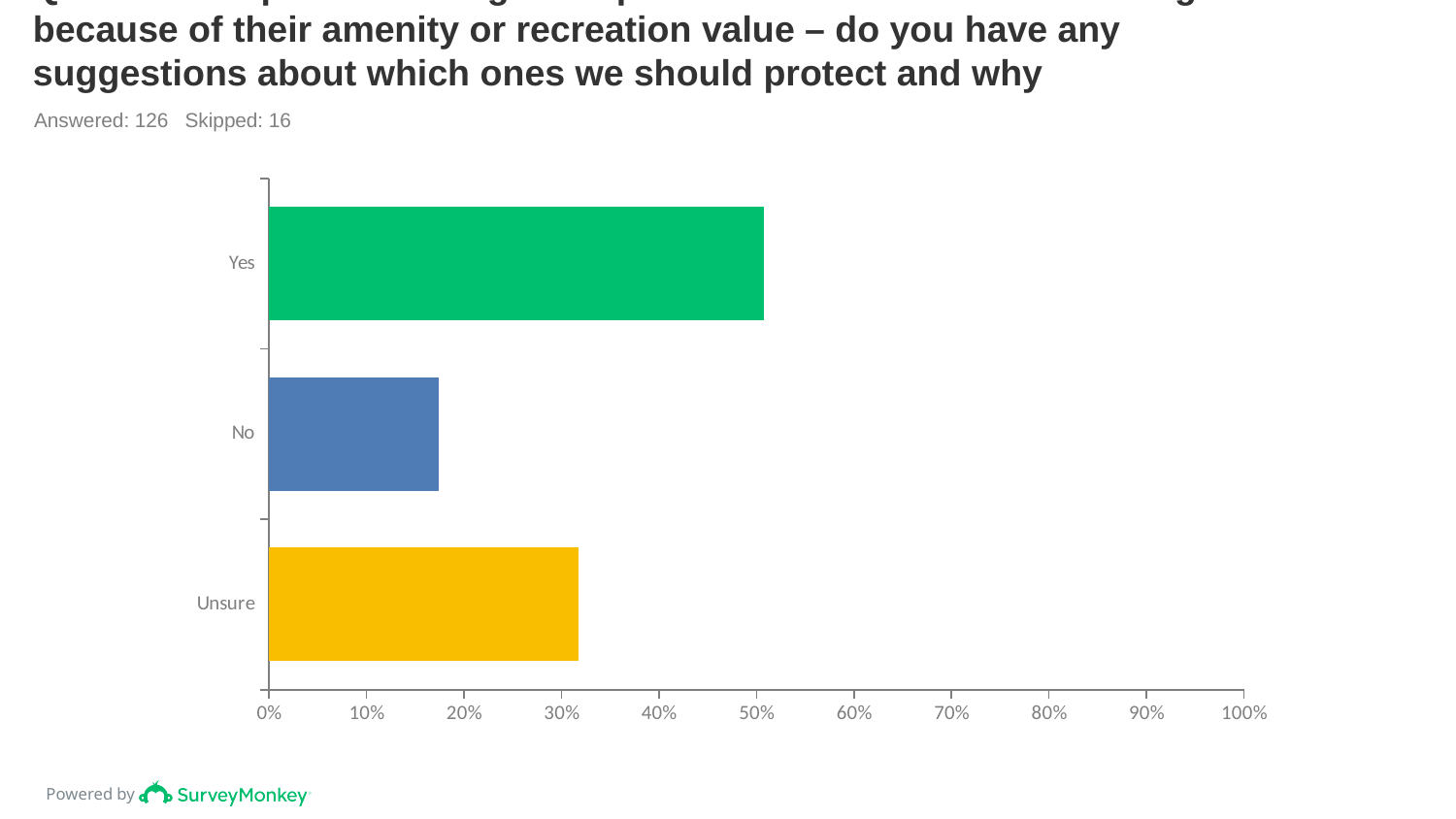
Which response category has the lowest value? No How many response categories are shown in the chart? 3 Is the value for Yes greater or less than 40%? greater Is the value for No greater or less than 10%? greater Is the value for Unsure greater or less than 40%? less What colour is the bar for Unsure? yellow Which is larger, the value for Yes or the value for Unsure? Yes How many respondents answered this question, according to the slide? 126 Which response category has the highest value? Yes Which is larger, the value for Unsure or the value for No? Unsure What kind of chart is shown on the slide? bar chart